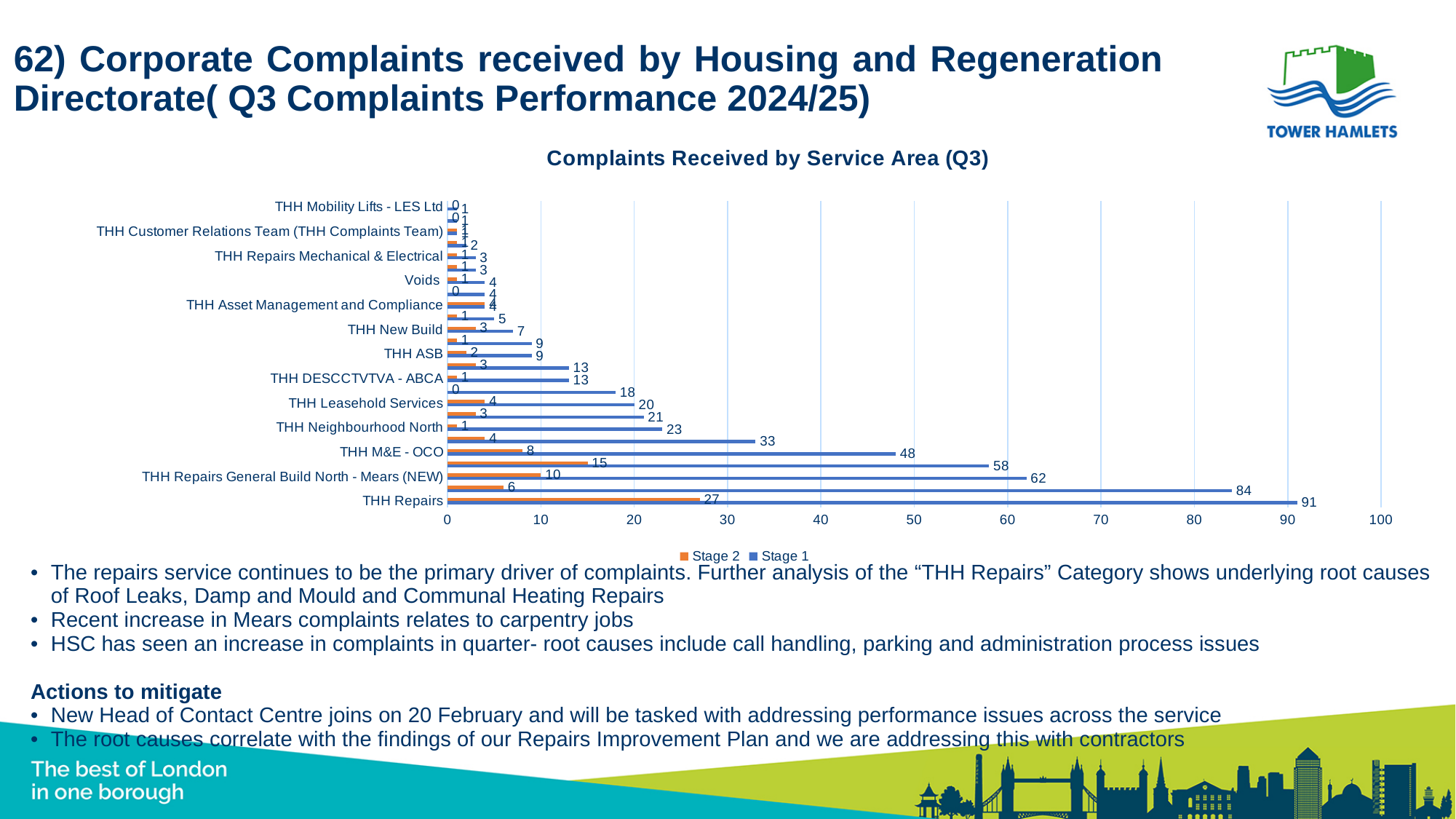
What is the title of the chart? Complaints Received by Service Area (Q3) What is the Stage 2 value for THH Repairs? 27 Is the Stage 1 value for THH Repairs General Build North - Mears (NEW) greater or less than 60? greater What is the Stage 1 value for THH Repairs General Build North - Mears (NEW)? 62 Which has the larger Stage 1 value, THH Leasehold Services or THH Neighbourhood North? THH Neighbourhood North What is the Stage 1 value for THH M&E - OCO? 48 Which service area has the highest Stage 1 value? THH Repairs What is the Stage 1 value for THH Repairs? 91 What is the difference between the Stage 1 and Stage 2 values for THH Repairs? 64 How many series does the legend of the chart list? 2 What kind of chart is shown on the slide? Bar chart What are the two series named in the chart legend? Stage 2 and Stage 1